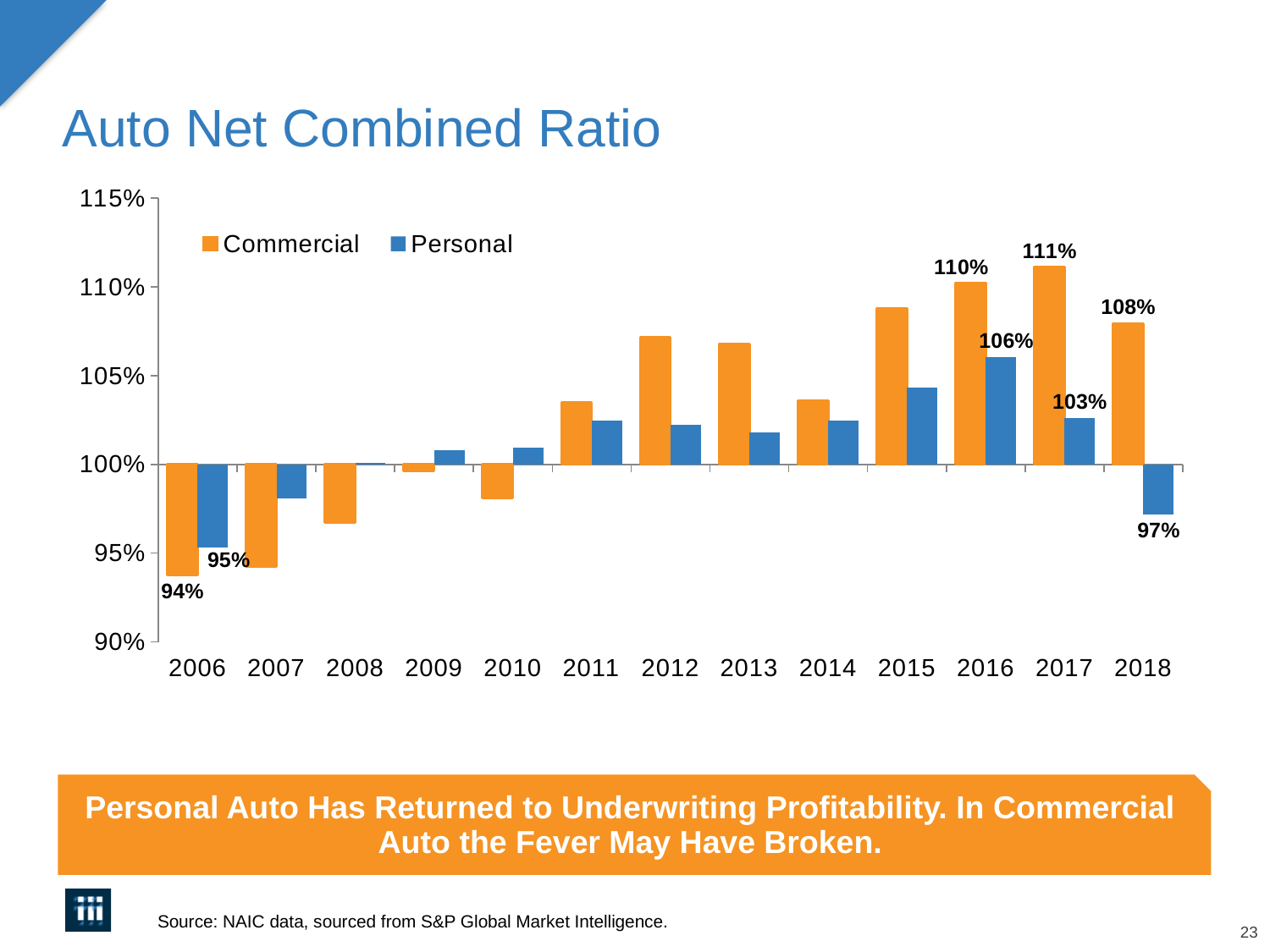
What is the Commercial auto net combined ratio for 2006? 94% In 2017, how many percentage points higher is the Commercial combined ratio than the Personal combined ratio? 8 percentage points How many series does the legend list? 2 What is the Personal auto net combined ratio for 2018? 97% Is the Commercial combined ratio for 2012 greater or less than 105%? greater What kind of chart is shown on the slide? Bar chart In which year is the Commercial combined ratio highest? 2017 Is the Personal combined ratio for 2007 greater or less than 100%? less In 2018, which series has the higher combined ratio, Commercial or Personal? Commercial What is the Personal auto net combined ratio for 2016? 106% What is the Commercial auto net combined ratio for 2017? 111% How many years are shown on the x axis of the chart? 13